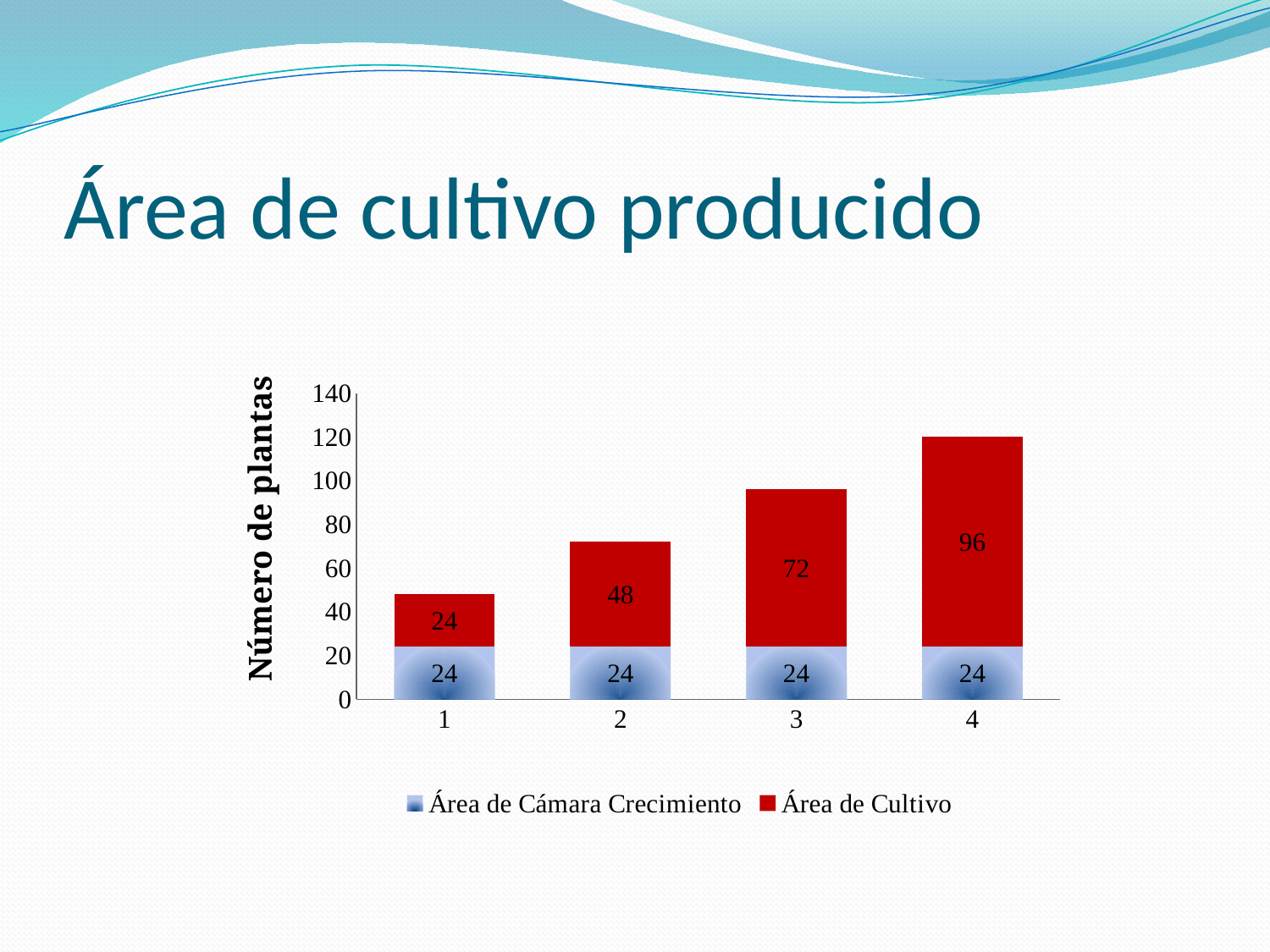
Does the Área de Cultivo value rise or fall from category 1 to category 4? rise How many series does the legend list? 2 What is the value of Área de Cultivo for category 3? 72 Which category has the highest value for Área de Cultivo? 4 What is the total of the stacked bar for category 4? 120 How many categories are shown on the x axis? 4 What is the label of the y axis? Número de plantas What type of chart is shown on the slide? stacked bar chart What is the value of Área de Cultivo for category 1? 24 What is the value of Área de Cámara Crecimiento for category 2? 24 What is the difference between the Área de Cultivo values for category 4 and category 2? 48 Which category has the lowest value for Área de Cultivo? 1